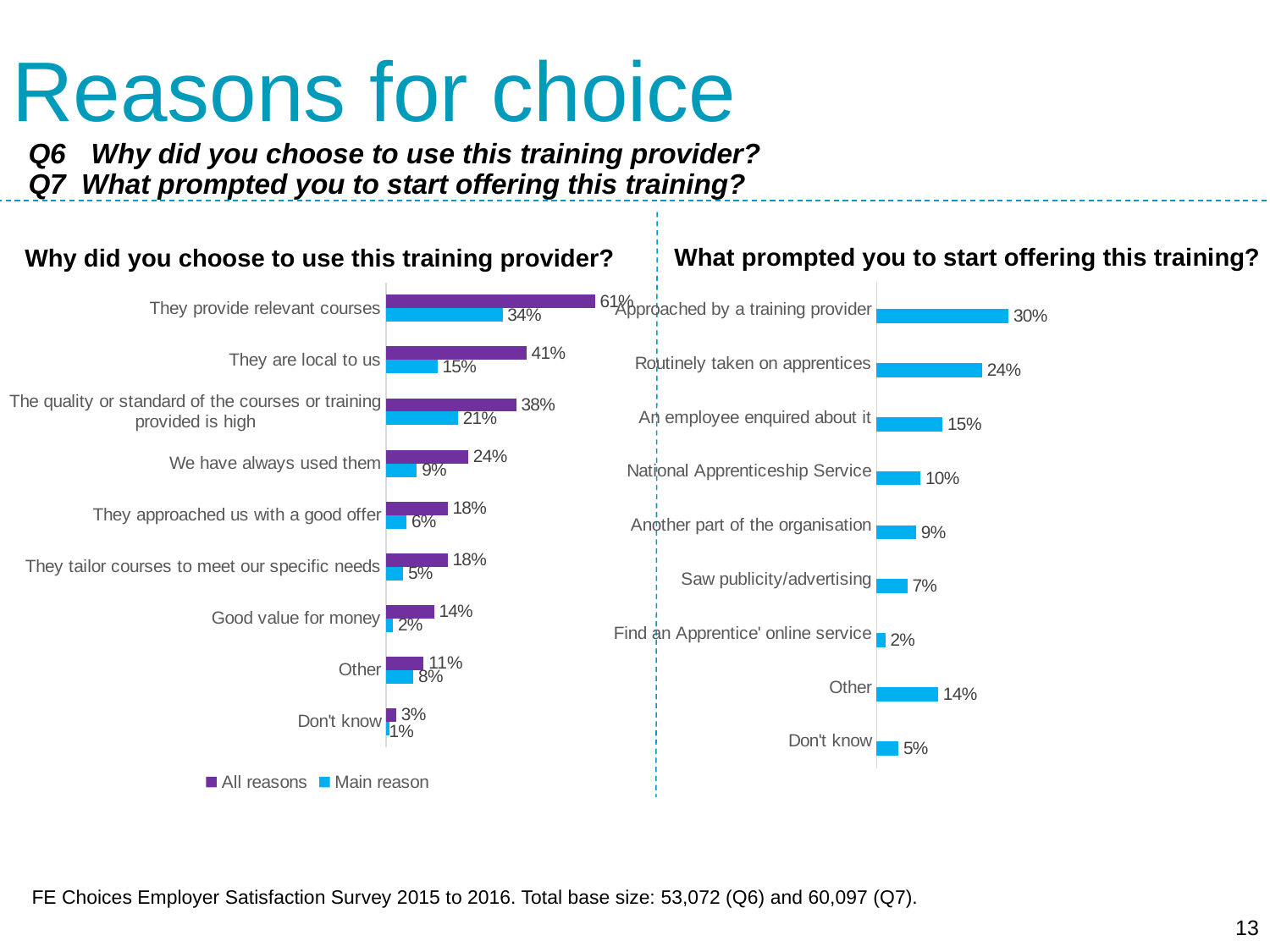
In the 'Why did you choose to use this training provider?' chart, what is the 'All reasons' value for 'They are local to us'? 41% In the 'Why did you choose to use this training provider?' chart, which is larger: the 'Main reason' value for 'We have always used them' or for 'Other'? We have always used them What type of chart is the 'Why did you choose to use this training provider?' chart? Bar chart In the 'Why did you choose to use this training provider?' chart, which category has the highest 'All reasons' value? They provide relevant courses In the 'What prompted you to start offering this training?' chart, which category has the lowest value? Find an Apprentice' online service In the 'What prompted you to start offering this training?' chart, which category has the highest value? Approached by a training provider How many categories are shown in the 'What prompted you to start offering this training?' chart? 9 In the 'What prompted you to start offering this training?' chart, what is the difference between 'Approached by a training provider' and 'Routinely taken on apprentices'? 6% How many series does the legend of the 'Why did you choose to use this training provider?' chart list? 2 In the 'Why did you choose to use this training provider?' chart, what is the difference between the 'All reasons' and 'Main reason' values for 'They provide relevant courses'? 27% In the 'Why did you choose to use this training provider?' chart, what is the 'Main reason' value for 'The quality or standard of the courses or training provided is high'? 21% In the 'What prompted you to start offering this training?' chart, what is the value for 'An employee enquired about it'? 15%